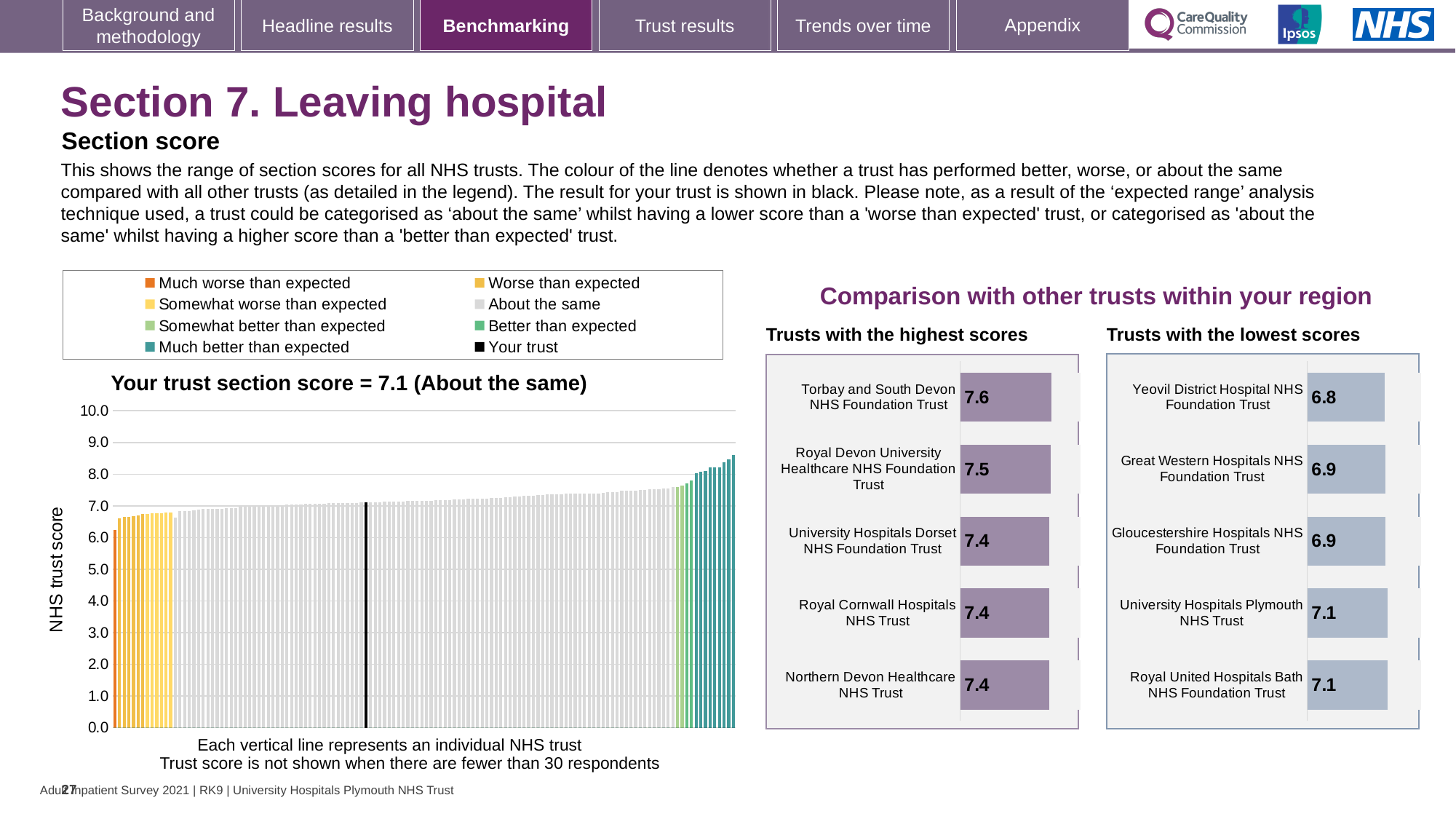
In the 'Trusts with the lowest scores' chart, what is the score for University Hospitals Plymouth NHS Trust? 7.1 In the 'Trusts with the lowest scores' chart, what is the score for Yeovil District Hospital NHS Foundation Trust? 6.8 How many trusts are shown in the 'Trusts with the lowest scores' chart? 5 In the 'Trusts with the lowest scores' chart, which trust has the lowest score? Yeovil District Hospital NHS Foundation Trust In the 'Trusts with the highest scores' chart, what is the difference between the scores of Torbay and South Devon NHS Foundation Trust and Northern Devon Healthcare NHS Trust? 0.2 In the 'Trusts with the highest scores' chart, what is the score for Torbay and South Devon NHS Foundation Trust? 7.6 In the main chart on the left, what is your trust's section score? 7.1 How many trusts are shown in the 'Trusts with the highest scores' chart? 5 In the 'Trusts with the highest scores' chart, which has the larger score: Royal Devon University Healthcare NHS Foundation Trust or University Hospitals Dorset NHS Foundation Trust? Royal Devon University Healthcare NHS Foundation Trust In the main chart on the left, what colour is used to show your trust? Black In the 'Trusts with the highest scores' chart, which trust has the highest score? Torbay and South Devon NHS Foundation Trust What kind of chart is the 'Trusts with the lowest scores' chart? Bar chart